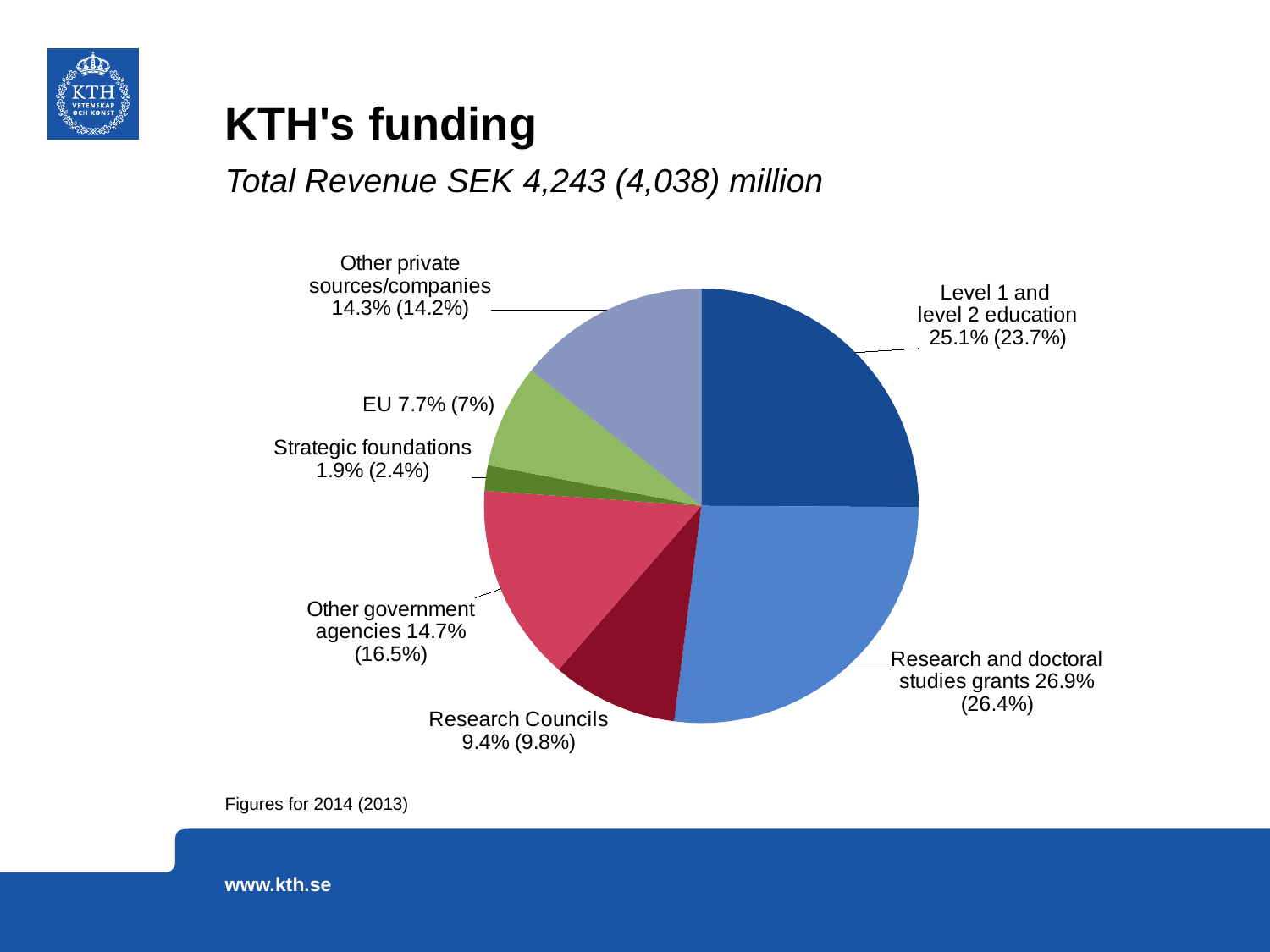
What kind of chart is shown on the slide? pie chart What share of KTH's funding in 2014 comes from Level 1 and level 2 education? 25.1% What is the title of the slide containing the pie chart? KTH's funding Which funding source has the largest share of the pie? Research and doctoral studies grants What share of KTH's funding in 2014 comes from Research and doctoral studies grants? 26.9% Which is larger in 2014: the share from Other government agencies or the share from Other private sources/companies? Other government agencies What was the 2013 share for Other government agencies, shown in parentheses? 16.5% Which funding source has the smallest share of the pie? Strategic foundations How many slices does the pie chart have? 7 What is the difference between the 2014 shares of Research and doctoral studies grants and Level 1 and level 2 education? 1.8% What share of funding in 2014 comes from the EU? 7.7% What is the 2014 share for Research Councils? 9.4%